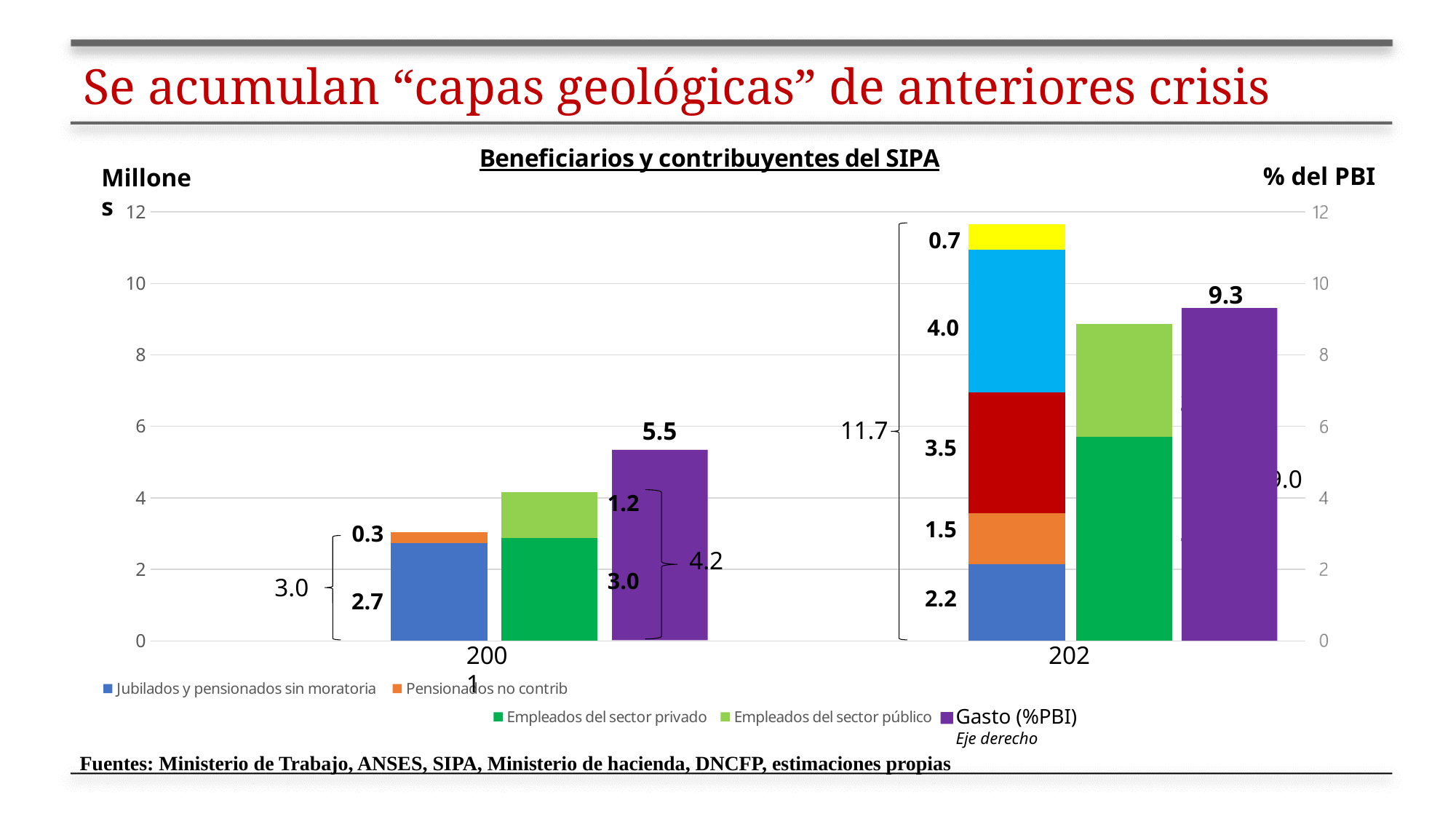
What is the value of Jubilados y pensionados sin moratoria for 2001? 2.7 What kind of chart is shown on the slide? Stacked bar chart What is the value of Pensionados no contrib in the right-hand year group? 1.5 What is the difference in Gasto (%PBI) between the right-hand year group and 2001? 3.8 What is the value of Gasto (%PBI) for 2001? 5.5 Is the Empleados (green) stacked bar in the right-hand year group greater or less than 8 on the left axis? greater What is the value of Empleados del sector público for 2001? 1.2 What is the total of the stacked beneficiaries bar (blue and orange) for 2001? 3.0 What is the total of the stacked beneficiaries bar in the right-hand year group, as shown by the bracket? 11.7 How many series does the chart legend list? 5 What is the value of Gasto (%PBI) for the right-hand year group? 9.3 What is the title of the chart? Beneficiarios y contribuyentes del SIPA